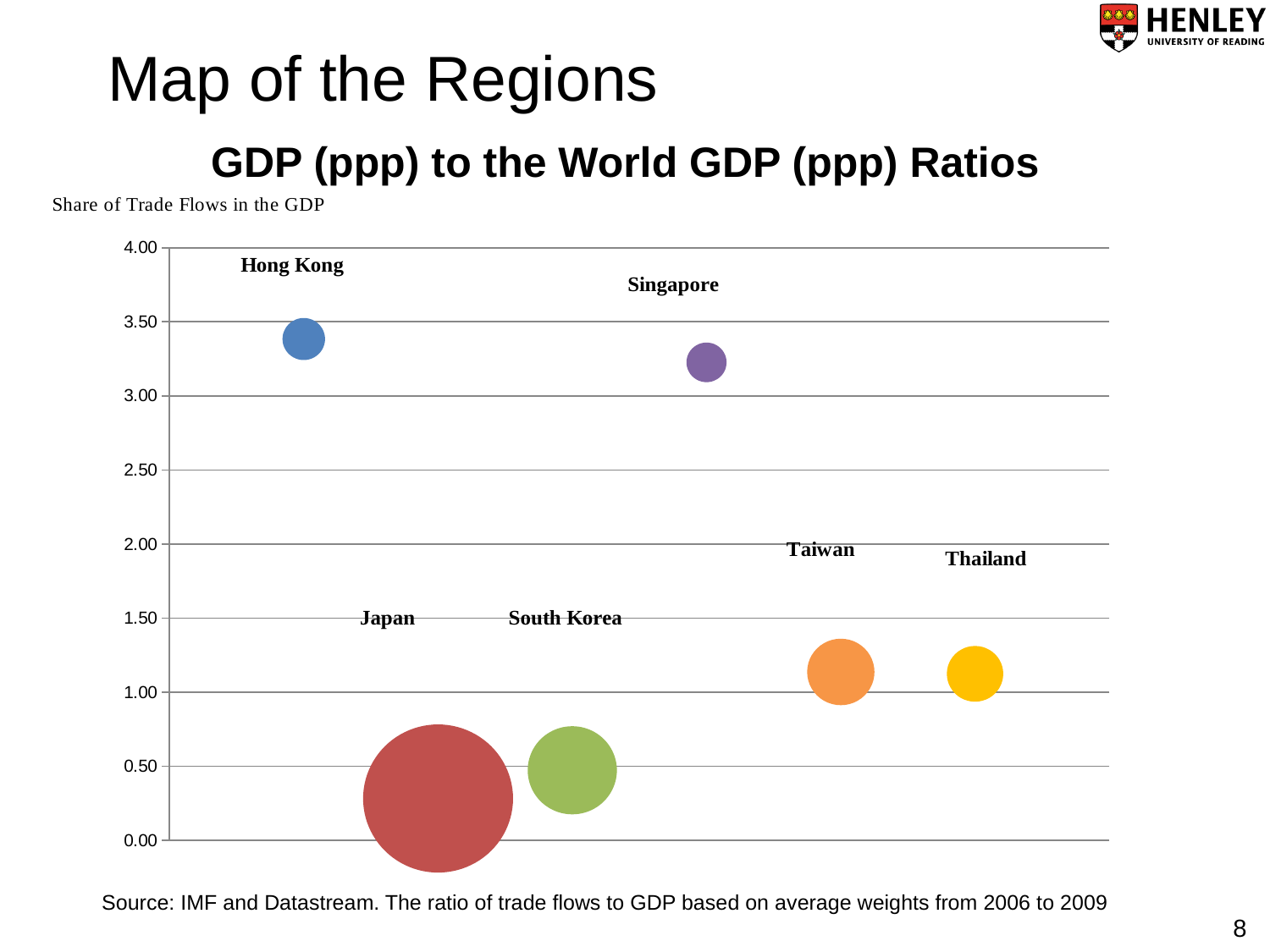
Which country has the lowest share of trade flows in the GDP on the chart? Japan Which country has the highest share of trade flows in the GDP on the chart? Hong Kong Which has the larger share of trade flows in the GDP, Japan or South Korea? South Korea Which has the larger share of trade flows in the GDP, Hong Kong or Singapore? Hong Kong Which country is represented by the largest bubble on the chart? Japan Is the value for Thailand greater or less than 1.50? less What kind of chart is shown on the slide? Bubble chart Is the value for Hong Kong greater or less than 3.00? greater How many countries are plotted on the chart? 6 Is the value for Singapore greater or less than 3.50? less